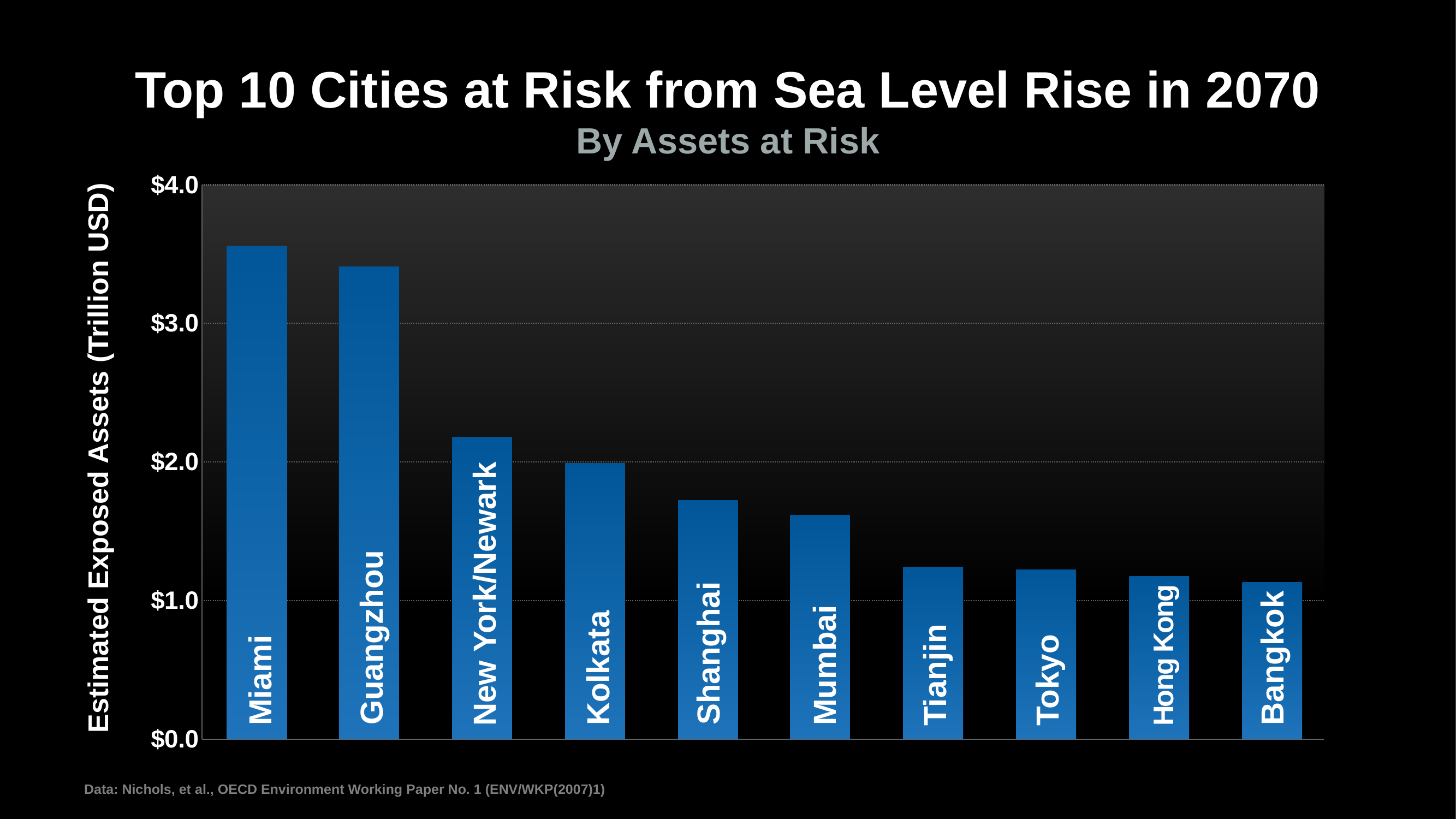
What is the label on the vertical axis? Estimated Exposed Assets (Trillion USD) Do the values rise or fall from left to right across the cities? Fall Which has a larger value, Miami or Kolkata? Miami Is the value for New York/Newark greater or less than $2.0? greater Is the value for Miami greater or less than $3.0? greater Which city has the highest estimated exposed assets? Miami Is the value for Shanghai greater or less than $2.0? less How many cities are shown in the chart? 10 What kind of chart is shown on the slide? Bar chart Which has a larger value, Shanghai or Tianjin? Shanghai